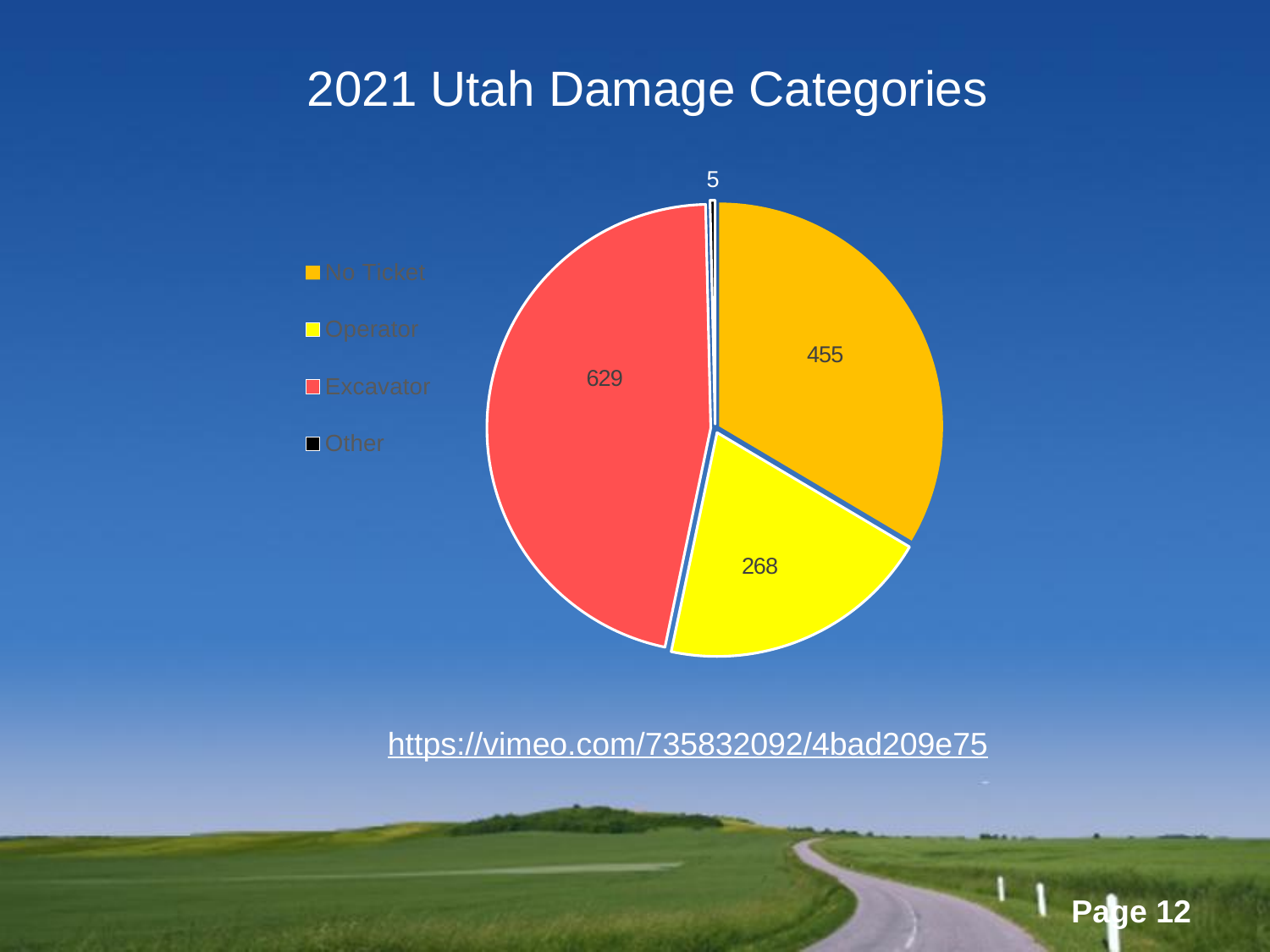
What is the value for Other? 5 What is the value for Excavator? 629 What is the title of the chart? 2021 Utah Damage Categories Which category has the largest slice? Excavator What is the difference between the Excavator and No Ticket values? 174 Which category has the smallest slice? Other What is the total of all four categories in the pie? 1357 What type of chart is shown on the slide? pie chart What is the value for Operator? 268 Which is larger, No Ticket or Operator? No Ticket What is the value for No Ticket? 455 How many categories does the legend list? 4